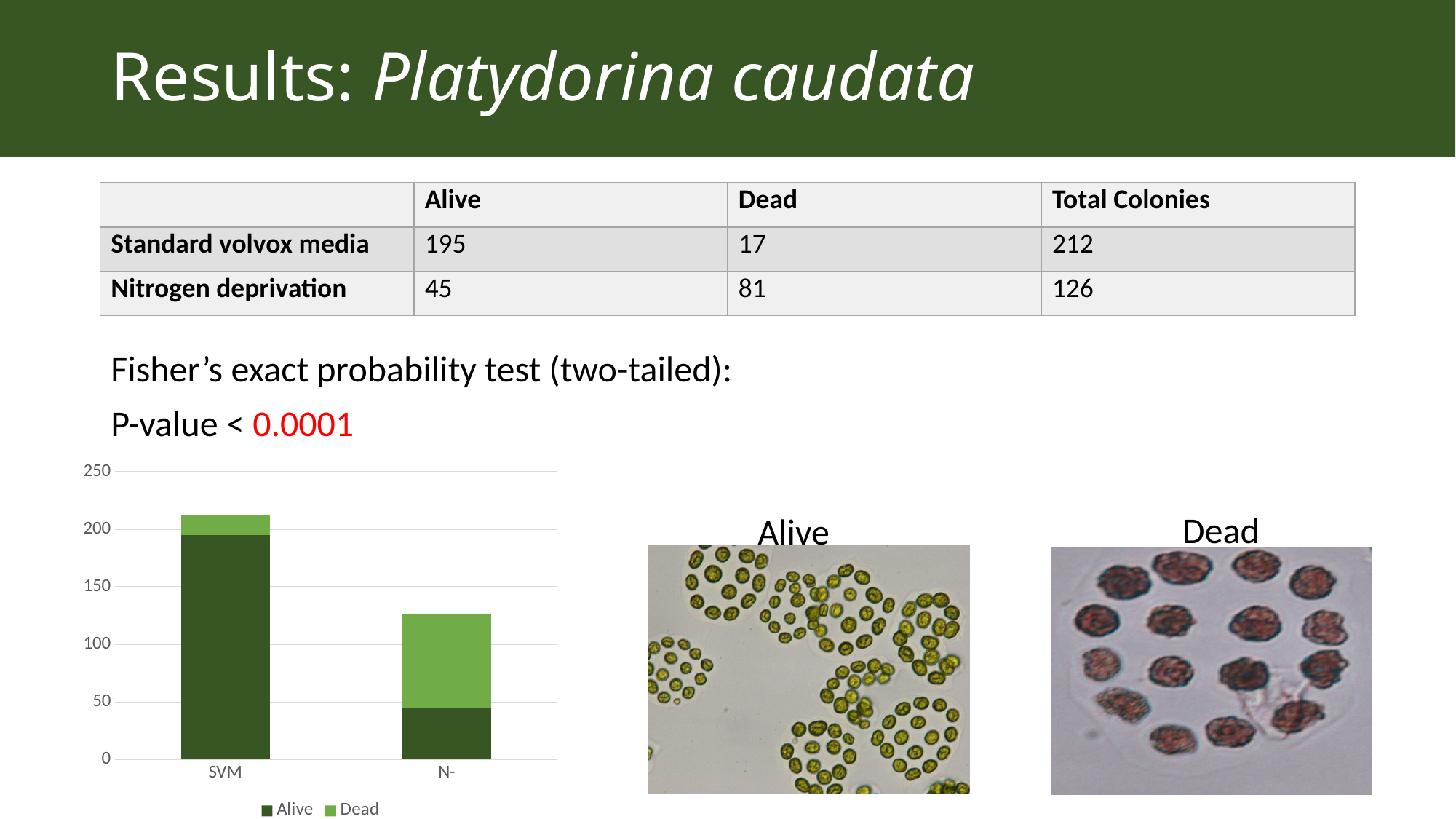
How many series does the bar chart's legend list? 2 Is the Alive value for N- greater or less than 50? less In which category is the Dead segment larger, SVM or N-? N- Which series are listed in the bar chart's legend? Alive, Dead Is the total height of the N- bar greater or less than 150? less Is the Alive value for SVM greater or less than 150? greater How many categories are shown on the x axis of the bar chart? 2 Which colour represents the Dead series in the bar chart? light green What kind of chart is shown on the slide? stacked bar chart Does the total bar height rise or fall from SVM to N-? fall Which category has the taller stacked bar, SVM or N-? SVM